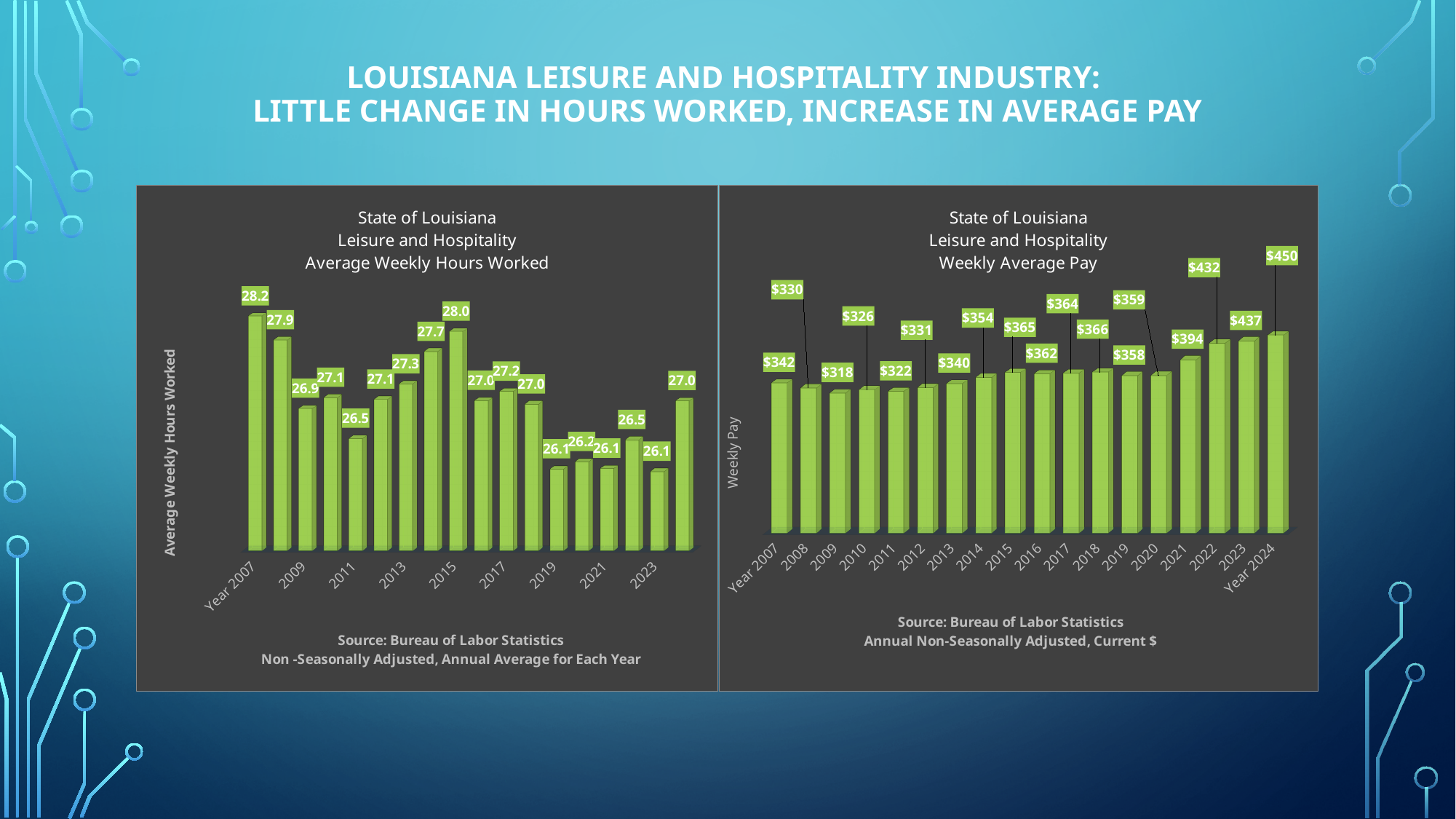
On the Weekly Average Pay chart (right), what is the value for 2021? $394 On the Weekly Average Pay chart (right), which year has the highest value? 2024 On the Average Weekly Hours Worked chart (left), what is the value for Year 2007? 28.2 On the Weekly Average Pay chart (right), how many years are plotted? 18 On the Weekly Average Pay chart (right), which year has the lowest value? 2009 On the Weekly Average Pay chart (right), which is larger, the value for 2015 or the value for 2019? 2015 On the Weekly Average Pay chart (right), what is the value for Year 2007? $342 On the Weekly Average Pay chart (right), do the values rise or fall from 2021 to 2024? rise On the Weekly Average Pay chart (right), what is the difference between the 2024 value and the Year 2007 value? $108 On the Average Weekly Hours Worked chart (left), what is the value for 2011? 26.5 On the Weekly Average Pay chart (right), what is the value for 2024? $450 On the Average Weekly Hours Worked chart (left), which year has the highest value? Year 2007